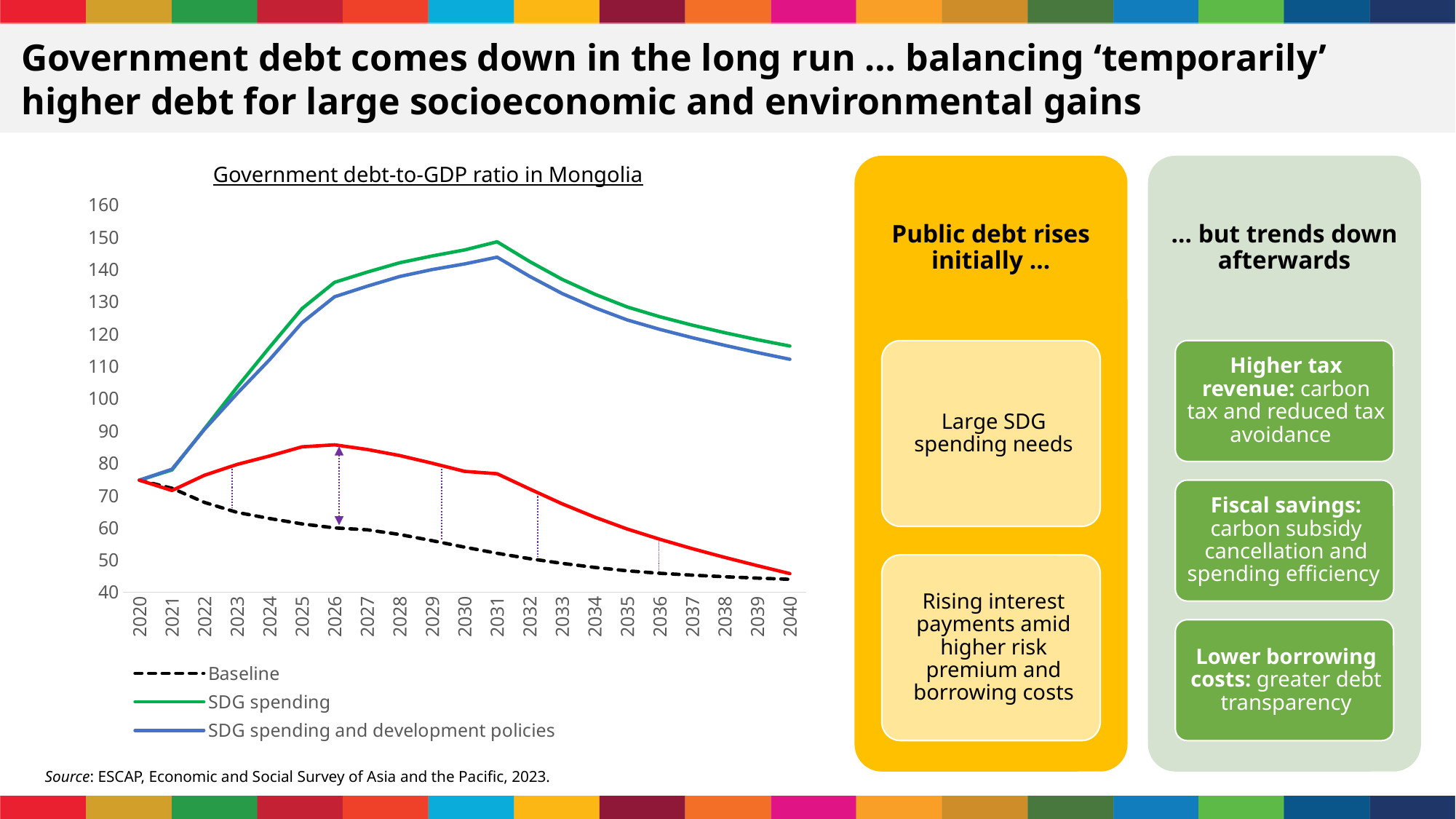
What kind of chart is shown on the slide? Line chart In 2040, which is larger: SDG spending or Baseline? SDG spending How many years are shown on the x axis of the chart? 21 Is the value for Baseline in 2040 greater or less than 50? less What is the title of the chart? Government debt-to-GDP ratio in Mongolia Which series is drawn as a dashed black line? Baseline Is the value for SDG spending in 2031 greater or less than 140? greater In which year is the Baseline series at its lowest value? 2040 Does the Baseline series rise or fall from 2020 to 2040? Fall Is the value for SDG spending and development policies in 2040 greater or less than 100? greater In which year does the SDG spending series reach its highest value? 2031 How many series does the chart legend list? 3